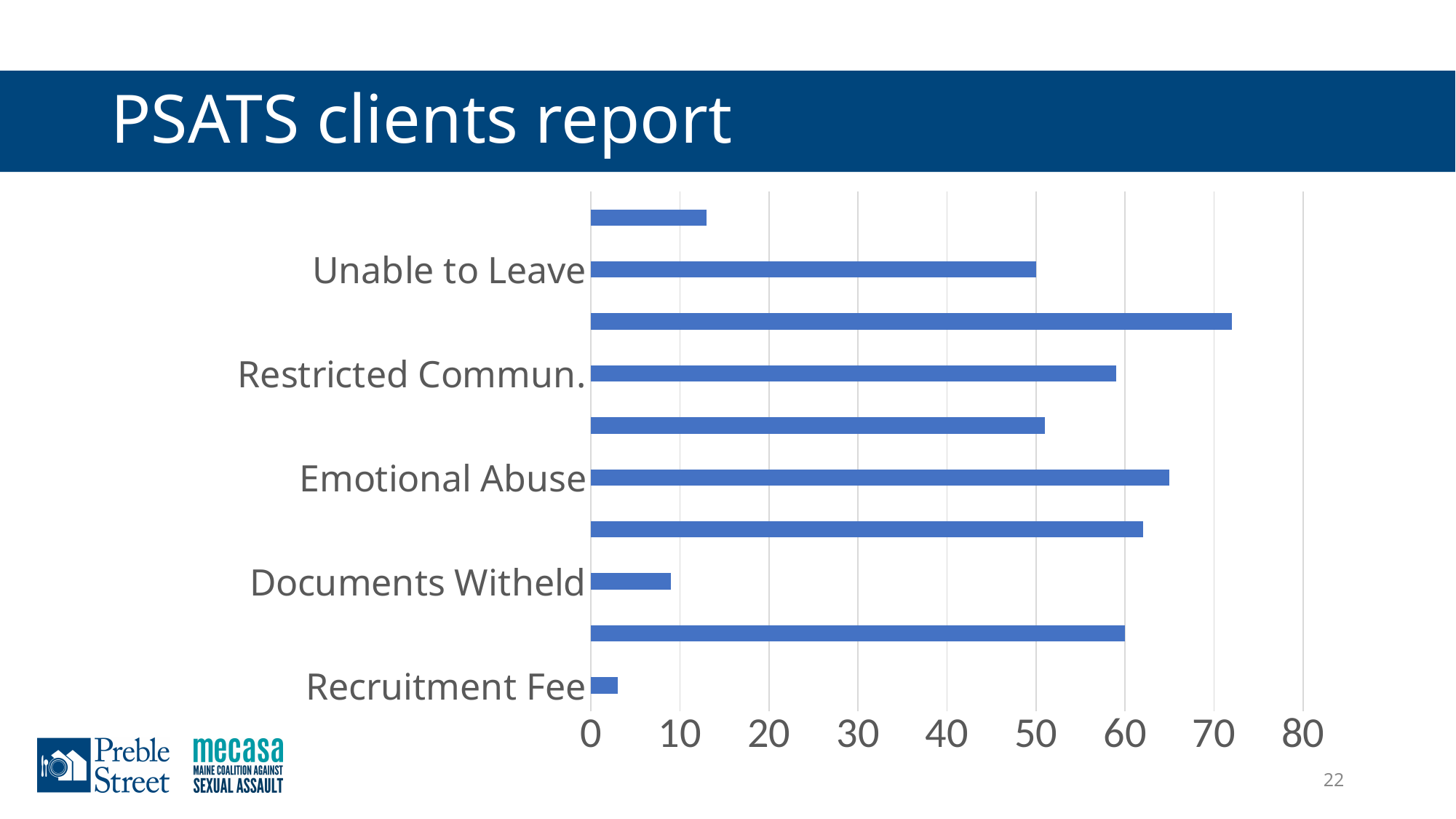
How many bars are plotted in the chart? 10 Which is larger, the value for Emotional Abuse or the value for Documents Witheld? Emotional Abuse Is the value for Documents Witheld greater or less than 10? less Which of the labeled categories has the lowest value? Recruitment Fee What is the title of the slide containing the chart? PSATS clients report Is the value for Recruitment Fee greater or less than 10? less Which is larger, the value for Restricted Commun. or the value for Unable to Leave? Restricted Commun. What kind of chart is shown on the slide? bar chart What is the highest value shown on the horizontal axis? 80 Is the value for Restricted Commun. greater or less than 50? greater